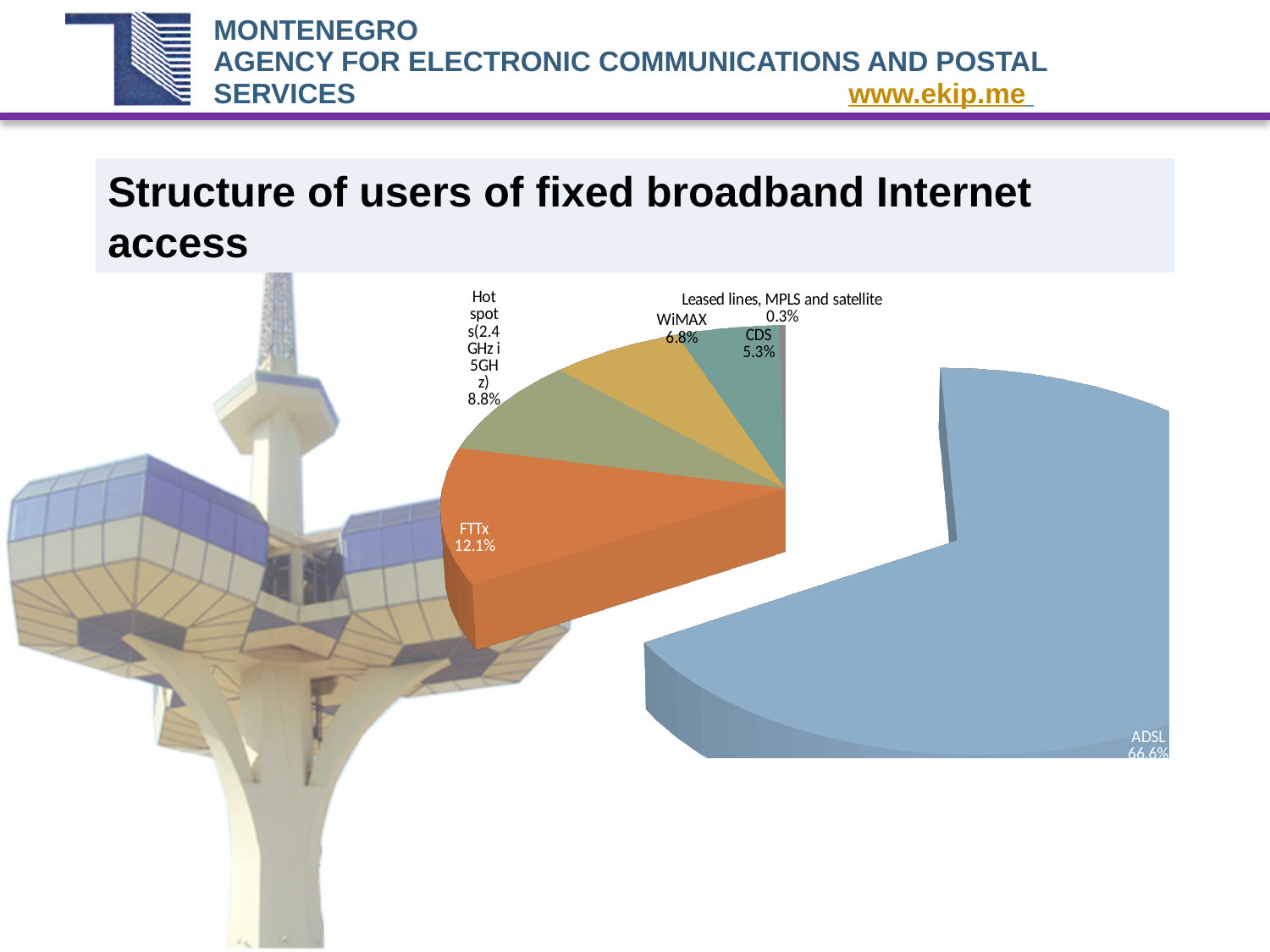
What is the value shown for Hot spots (2.4 GHz i 5GHz)? 8.8% Which is larger, the share for WiMAX or the share for CDS? WiMAX What percentage is shown for WiMAX? 6.8% What is the value shown for FTTx? 12.1% What is the value shown for CDS? 5.3% What is the difference in percentage points between ADSL and FTTx? 54.5 Which category has the smallest share of the pie? Leased lines, MPLS and satellite Which category has the largest share of the pie? ADSL How many slices does the pie chart have? 6 What share of fixed broadband users does ADSL account for? 66.6% What percentage is shown for Leased lines, MPLS and satellite? 0.3% What kind of chart is shown on the slide? Pie chart